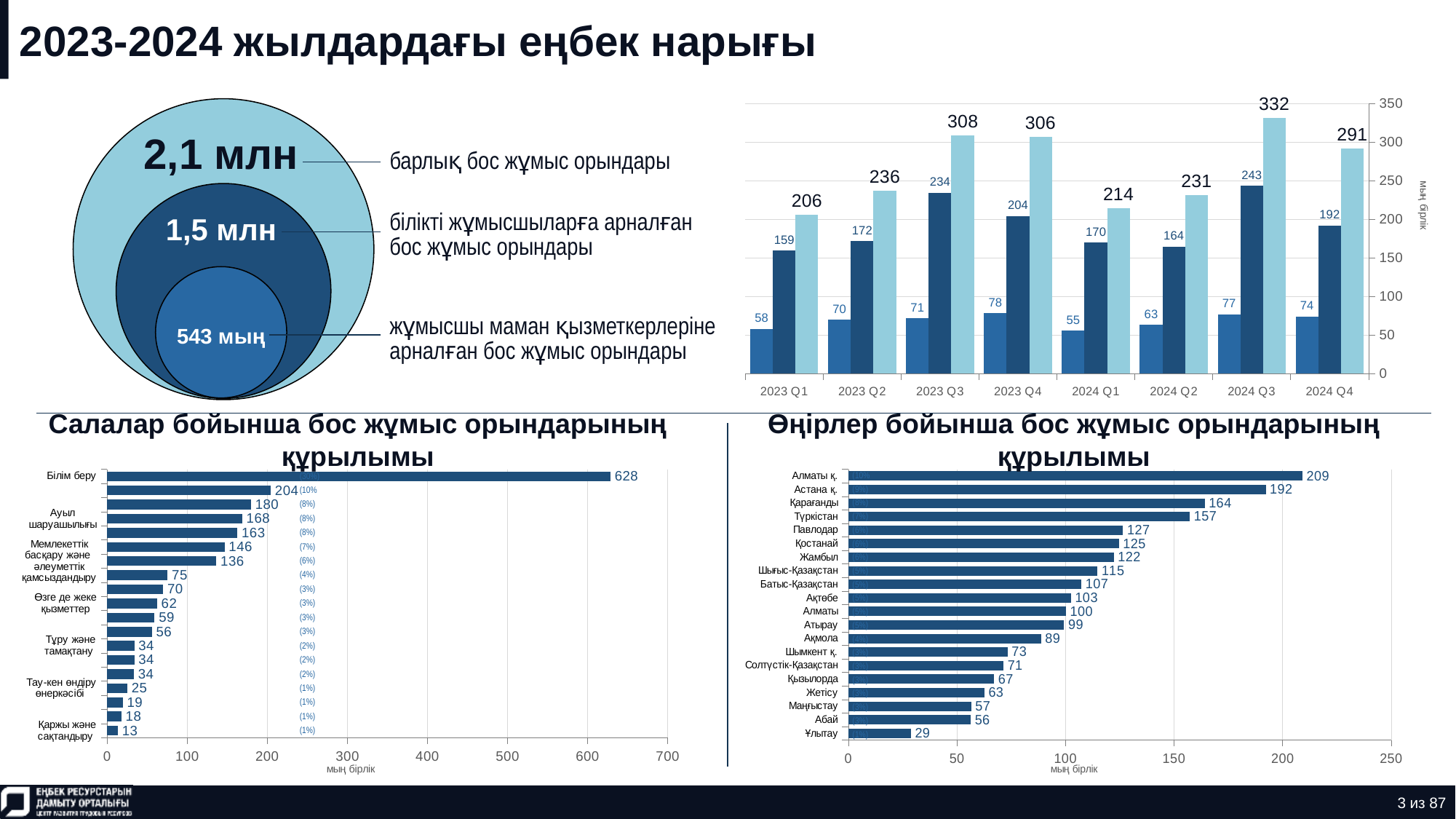
How many quarters are shown on the x axis of the quarterly chart at the top right? 8 In the quarterly chart at the top right, what is the value of the tallest (light blue) bar for 2024 Q3? 332 What kind of chart is the 'Салалар бойынша бос жұмыс орындарының құрылымы' chart? Bar chart In the 'Өңірлер бойынша бос жұмыс орындарының құрылымы' chart, which region has the highest value? Алматы қ. In the 'Өңірлер бойынша бос жұмыс орындарының құрылымы' chart, what is the value for Қарағанды? 164 In the 'Өңірлер бойынша бос жұмыс орындарының құрылымы' chart, which is larger: Павлодар or Жамбыл? Павлодар In the 'Салалар бойынша бос жұмыс орындарының құрылымы' chart, what is the value for Қаржы және сақтандыру? 13 In the 'Өңірлер бойынша бос жұмыс орындарының құрылымы' chart, what is the difference between Астана қ. and Шымкент қ.? 119 In the quarterly chart at the top right, which quarter has the highest light blue bar? 2024 Q3 In the 'Өңірлер бойынша бос жұмыс орындарының құрылымы' chart, which region has the lowest value? Ұлытау How many regions are shown in the 'Өңірлер бойынша бос жұмыс орындарының құрылымы' chart? 20 In the 'Салалар бойынша бос жұмыс орындарының құрылымы' chart, what is the value for Білім беру? 628